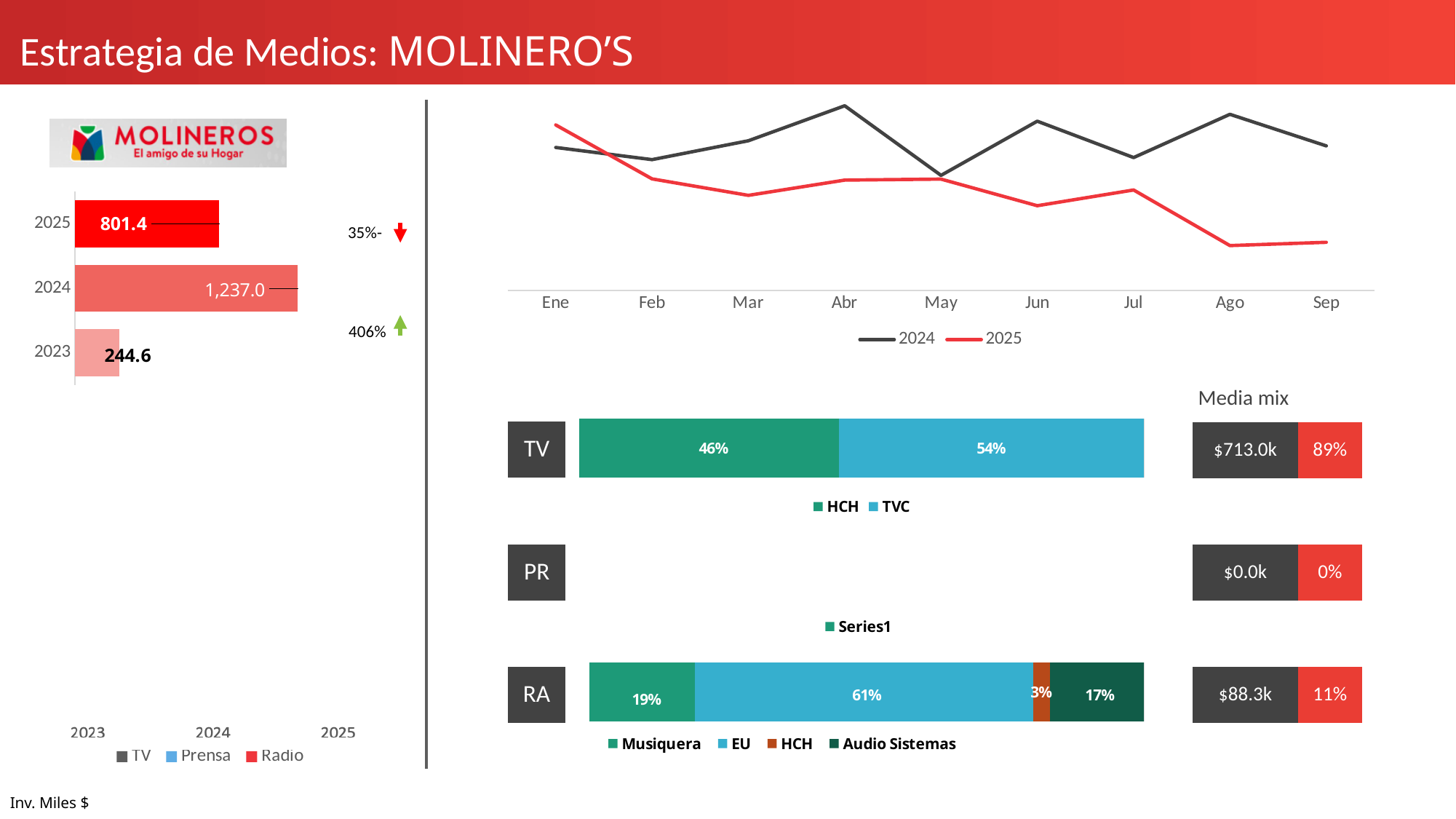
In the Media mix table, what is the amount shown for TV? $713.0k What kind of chart is the yearly investment chart on the left? bar chart In the TV stacked bar, what is the share for TVC? 54% In the monthly line chart at the top right, how many months are shown on the x axis? 9 In the left bar chart of yearly investment, what is the value for 2023? 244.6 In the monthly line chart at the top right, does the 2025 line generally rise or fall from Ene to Sep? fall In the RA stacked bar, which segment is the largest? EU In the left bar chart of yearly investment, what is the difference between the 2024 and 2025 values? 435.6 In the left bar chart of yearly investment, what is the value for 2024? 1,237.0 In the left bar chart of yearly investment, which year has the highest value? 2024 In the monthly line chart at the top right, how many series does the legend list? 2 In the monthly line chart at the top right, which series is higher in Sep, 2024 or 2025? 2024